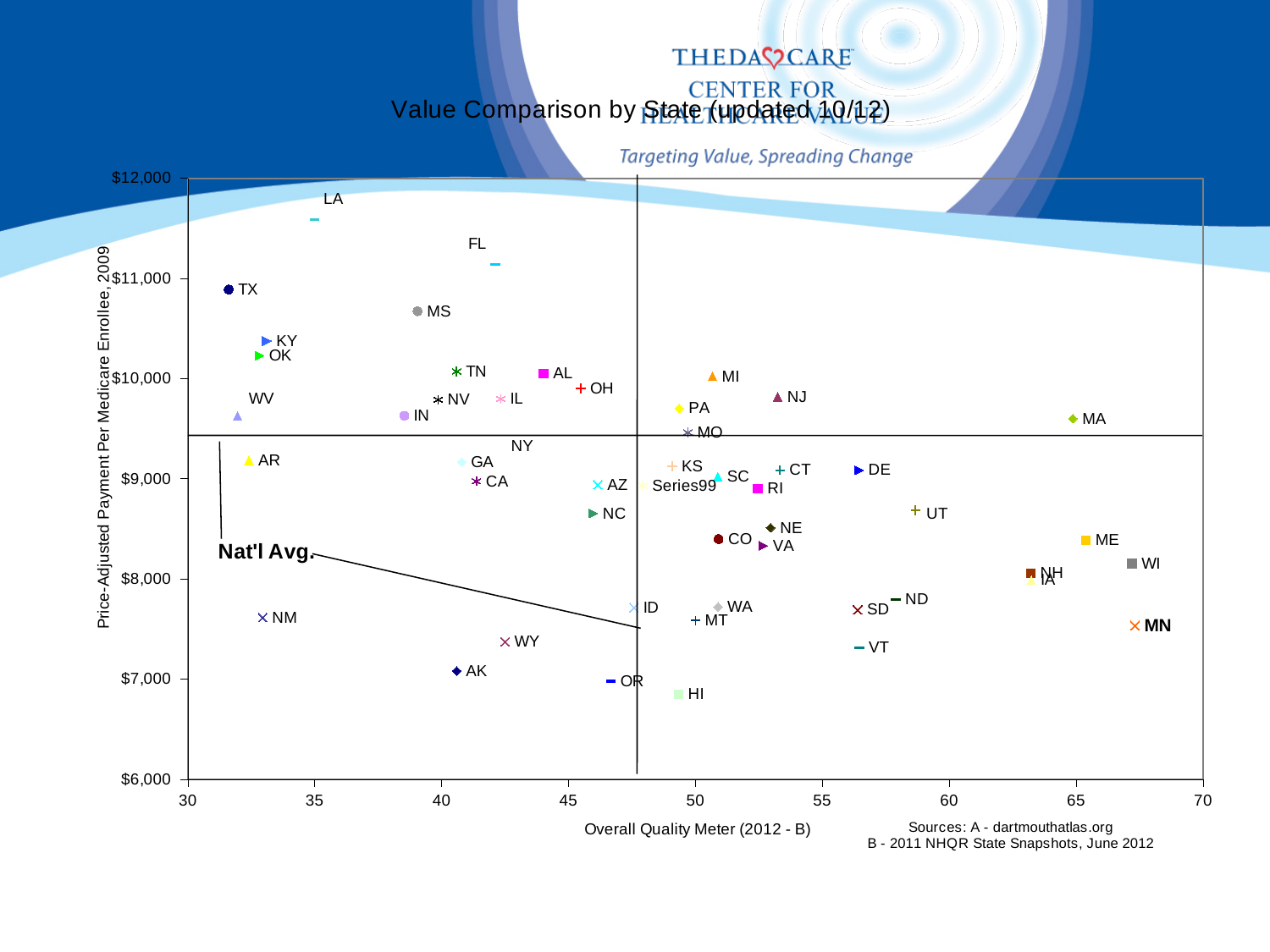
Which state has the highest price-adjusted payment per Medicare enrollee? LA Is the price-adjusted payment for LA greater or less than $11,000? greater What kind of chart is shown on the slide? scatter chart Is the overall quality score for MA greater or less than 60? greater Is the price-adjusted payment for HI greater or less than $7,000? less Which state has the higher price-adjusted payment, TX or MN? TX What is the label of the x axis? Overall Quality Meter (2012 - B) Which state has the higher overall quality score, ME or AK? ME Which state has the lowest price-adjusted payment per Medicare enrollee? HI What is the title of the chart? Value Comparison by State (updated 10/12)